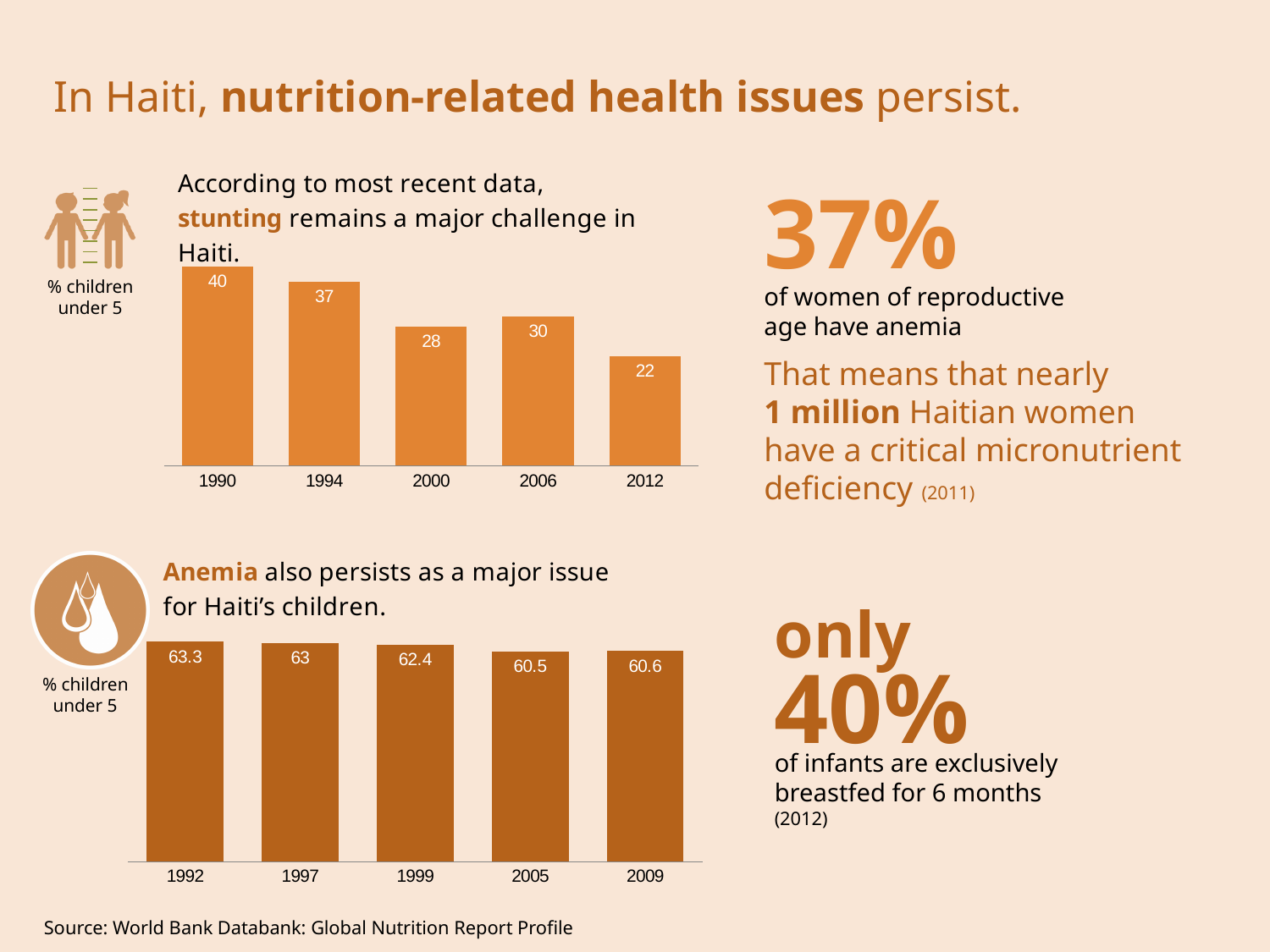
In the anemia chart (bottom), what is the difference between the values for 1997 and 1999? 0.6 In the stunting chart (top), which is larger, the value for 2000 or the value for 2006? 2006 What kind of chart is the anemia chart (bottom)? Bar chart In the stunting chart (top), what is the value for 1990? 40 In the stunting chart (top), what is the value for 2012? 22 In the stunting chart (top), which year has the highest value? 1990 In the anemia chart (bottom), which year has the highest value? 1992 In the anemia chart (bottom), what is the value for 2005? 60.5 In the stunting chart (top), how many years are shown on the x axis? 5 In the stunting chart (top), what is the difference between the values for 1990 and 2012? 18 In the anemia chart (bottom), what is the value for 1992? 63.3 In the stunting chart (top), which year has the lowest value? 2012